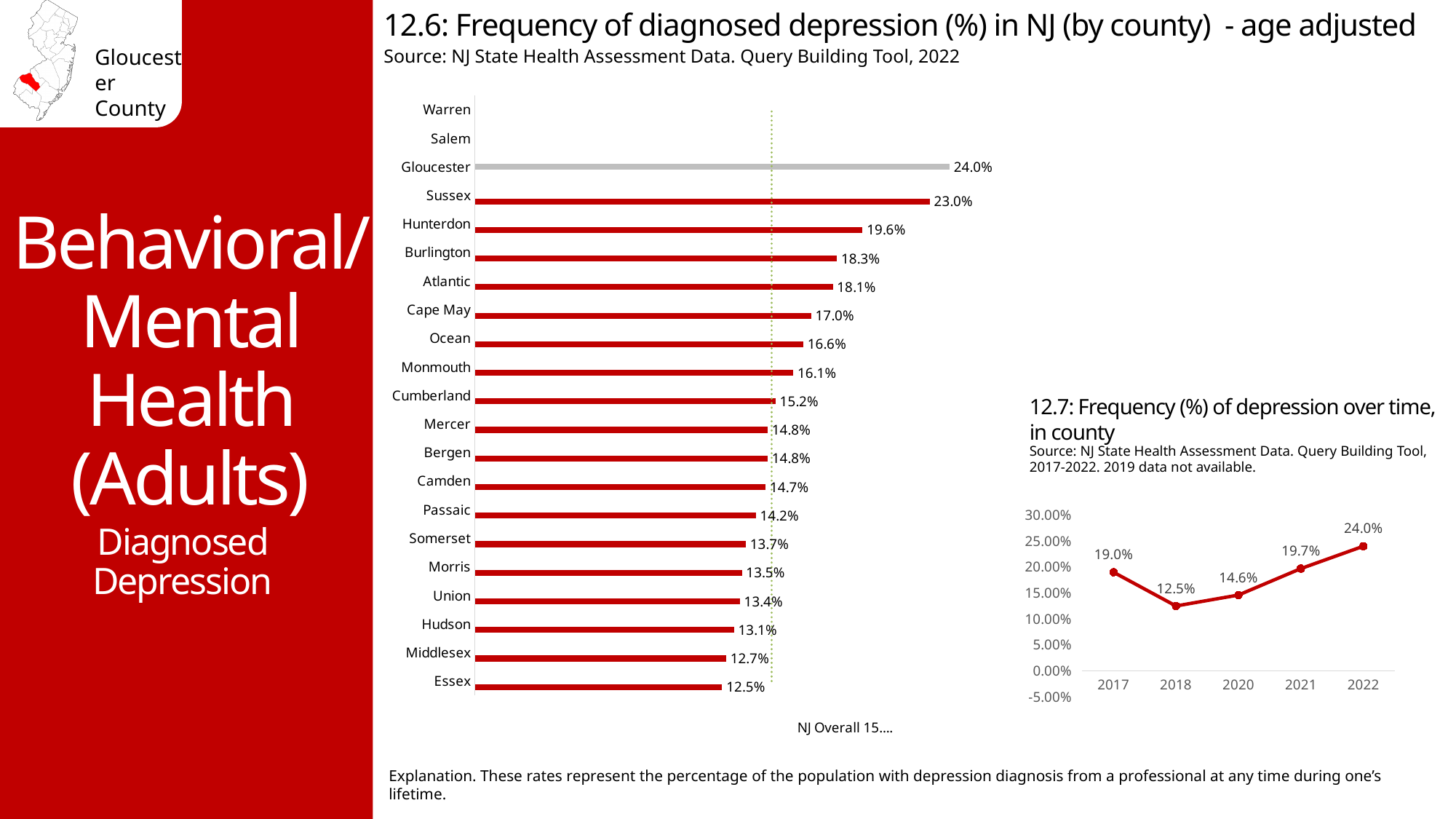
In chart 12.6, what is the difference between the values for Gloucester and Sussex? 1.0% In chart 12.6, what is the frequency of diagnosed depression for Gloucester County? 24.0% In chart 12.6, what is the value shown for Hunterdon? 19.6% In chart 12.6, which county has the highest value? Gloucester In chart 12.7, what is the value for 2022? 24.0% What kind of chart is chart 12.6? Bar chart In chart 12.6, which county with a plotted bar has the lowest value? Essex In chart 12.7, how many data points are plotted? 5 In chart 12.7, do the values rise or fall from 2018 to 2022? Rise In chart 12.7, what is the value for 2018? 12.5% In chart 12.6, which has a larger value, Burlington or Atlantic? Burlington In chart 12.7, what is the difference between the 2022 and 2017 values? 5.0%